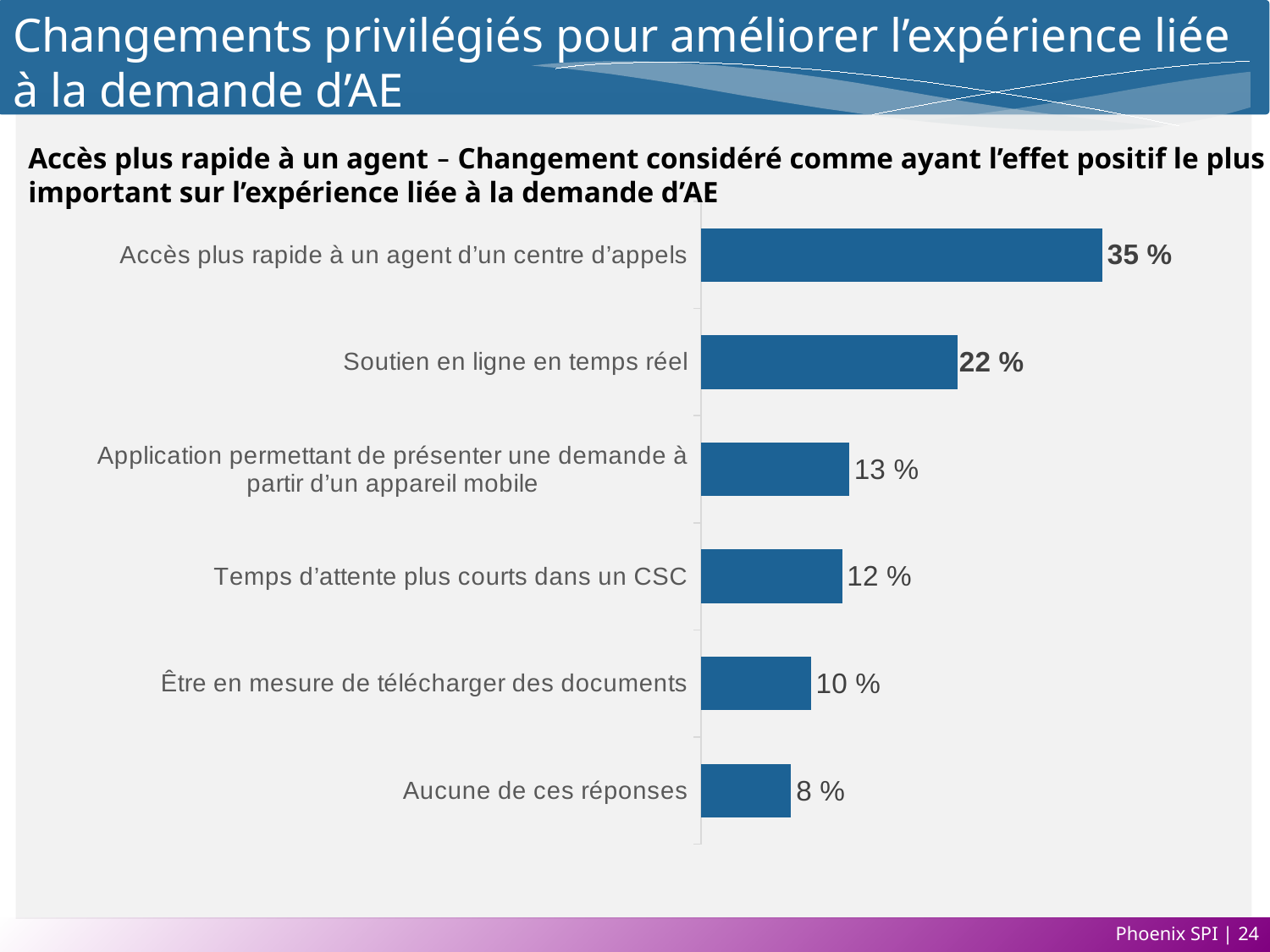
Which category has the highest value? Accès plus rapide à un agent d'un centre d'appels Which is larger: the value for "Application permettant de présenter une demande à partir d'un appareil mobile" or the value for "Aucune de ces réponses"? Application permettant de présenter une demande à partir d'un appareil mobile Which category has the lowest value? Aucune de ces réponses What kind of chart is shown on the slide? Bar chart What is the difference between the values for "Application permettant de présenter une demande à partir d'un appareil mobile" and "Temps d'attente plus courts dans un CSC"? 1 % What colour are the bars in the chart? Blue What is the difference between the values for "Accès plus rapide à un agent d'un centre d'appels" and "Soutien en ligne en temps réel"? 13 % What is the value for "Être en mesure de télécharger des documents"? 10 % How many categories are shown in the chart? 6 What is the value for "Accès plus rapide à un agent d'un centre d'appels"? 35 % What is the value for "Soutien en ligne en temps réel"? 22 % What is the value for "Temps d'attente plus courts dans un CSC"? 12 %